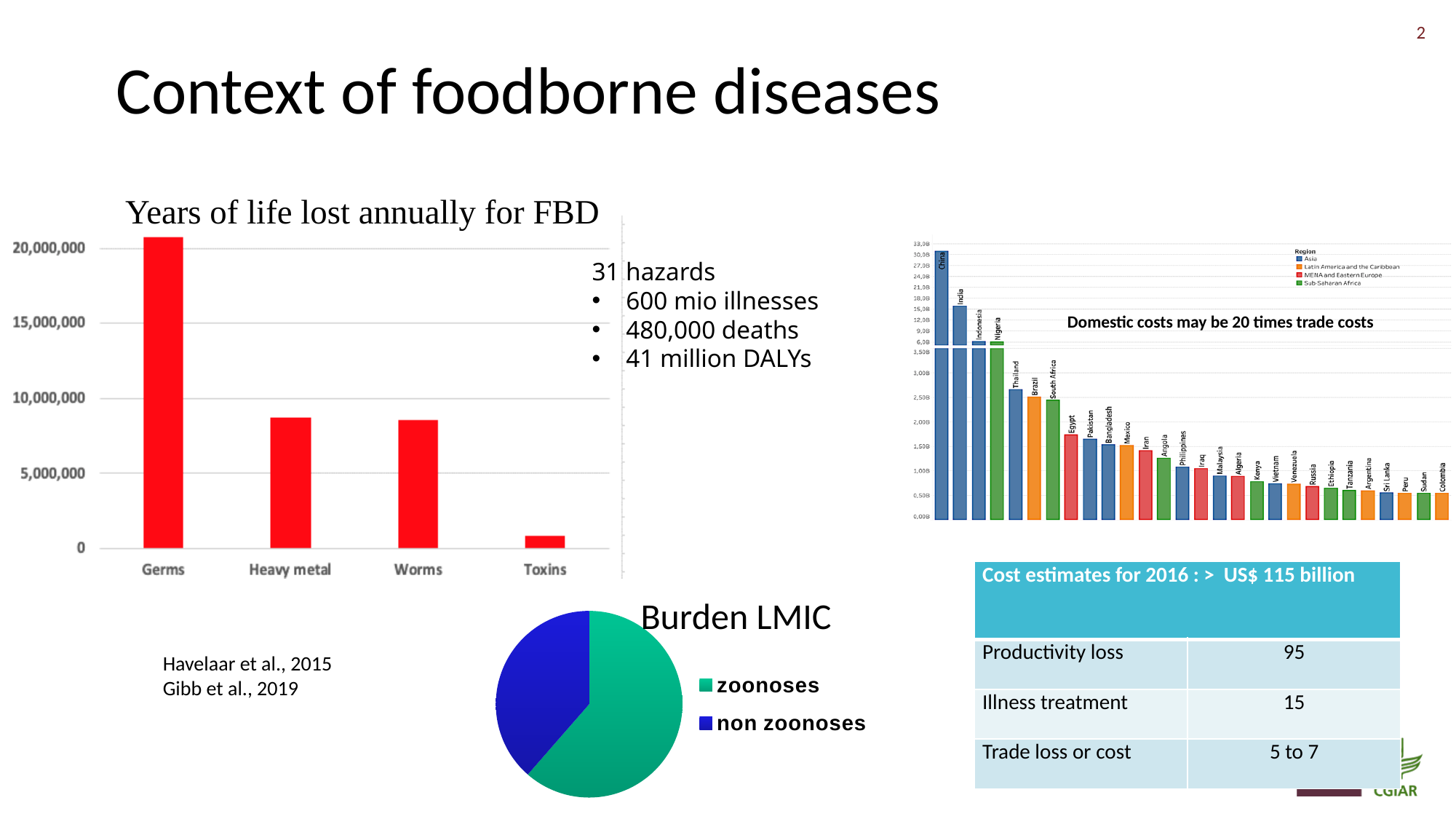
In the 'Years of life lost annually for FBD' chart, is the value for Heavy metal greater or less than 10,000,000? less In the 'Years of life lost annually for FBD' chart, is the value for Germs greater or less than 20,000,000? greater In the 'Years of life lost annually for FBD' chart, which is larger, Germs or Worms? Germs What type of chart is 'Burden LMIC'? pie chart In the 'Years of life lost annually for FBD' chart, is the value for Toxins greater or less than 5,000,000? less What type of chart is 'Years of life lost annually for FBD'? bar chart In the 'Years of life lost annually for FBD' chart, which category has the highest value? Germs In the 'Years of life lost annually for FBD' chart, which category has the lowest value? Toxins In the country bar chart on the right, which country has the highest value? China How many regions does the legend of the country bar chart on the right list? 4 In the 'Burden LMIC' pie chart, which slice is larger, zoonoses or non zoonoses? zoonoses How many categories are shown in the 'Years of life lost annually for FBD' chart? 4